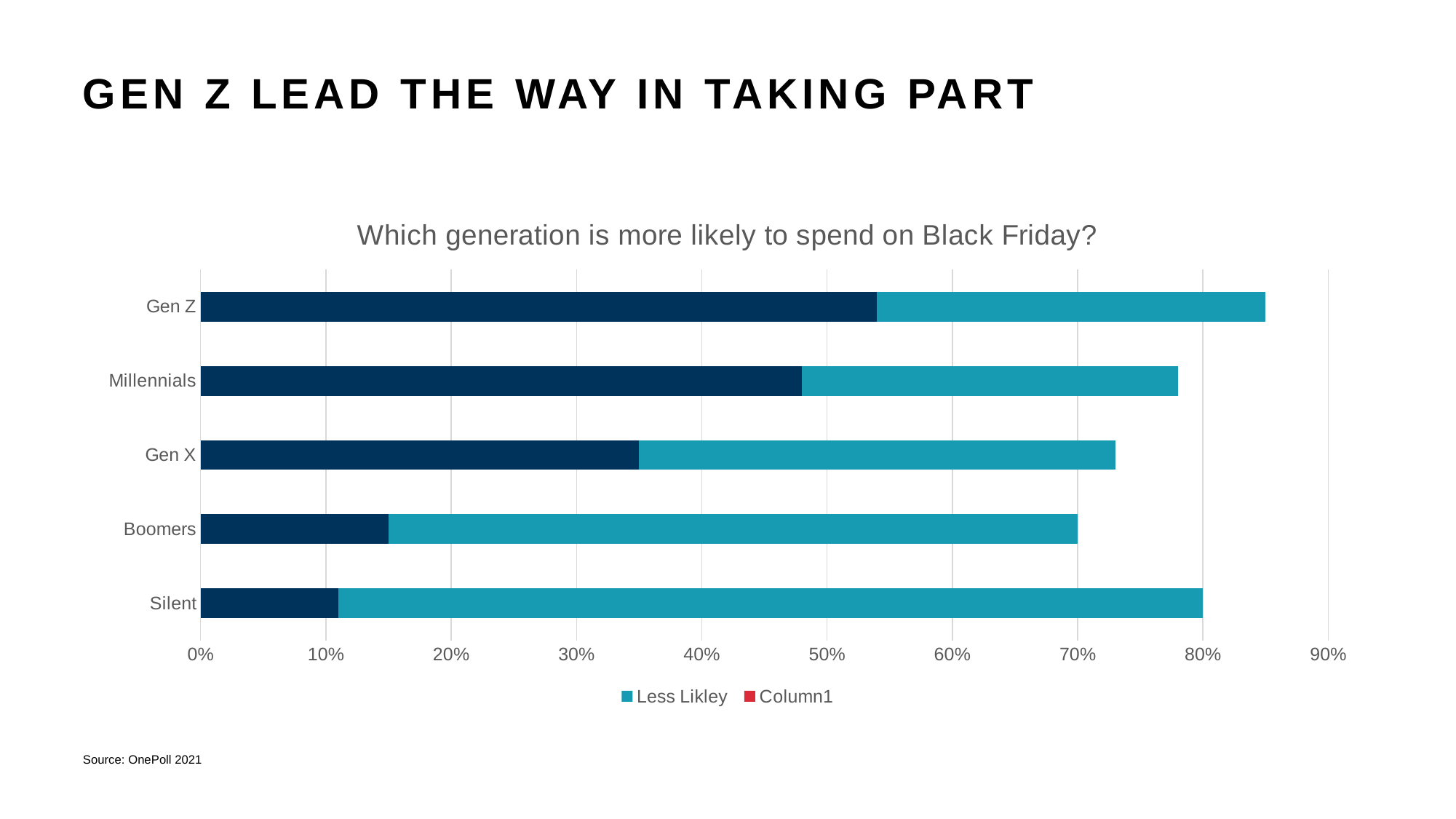
What type of chart is shown on the slide? Stacked bar chart Which has the larger dark navy segment, Gen X or Boomers? Gen X How many generations are shown on the chart? 5 Is the dark navy segment for Gen Z greater or less than 50%? greater How many series does the legend list? 2 Which generation has the longest total bar? Gen Z Which generation has the smallest dark navy segment? Silent Is the dark navy segment for Boomers greater or less than 20%? less Is the total bar length for Gen Z greater or less than 80%? greater What is the title of the chart? Which generation is more likely to spend on Black Friday? Which two entries appear in the chart legend? Less Likley and Column1 Which generation has the largest dark navy segment? Gen Z